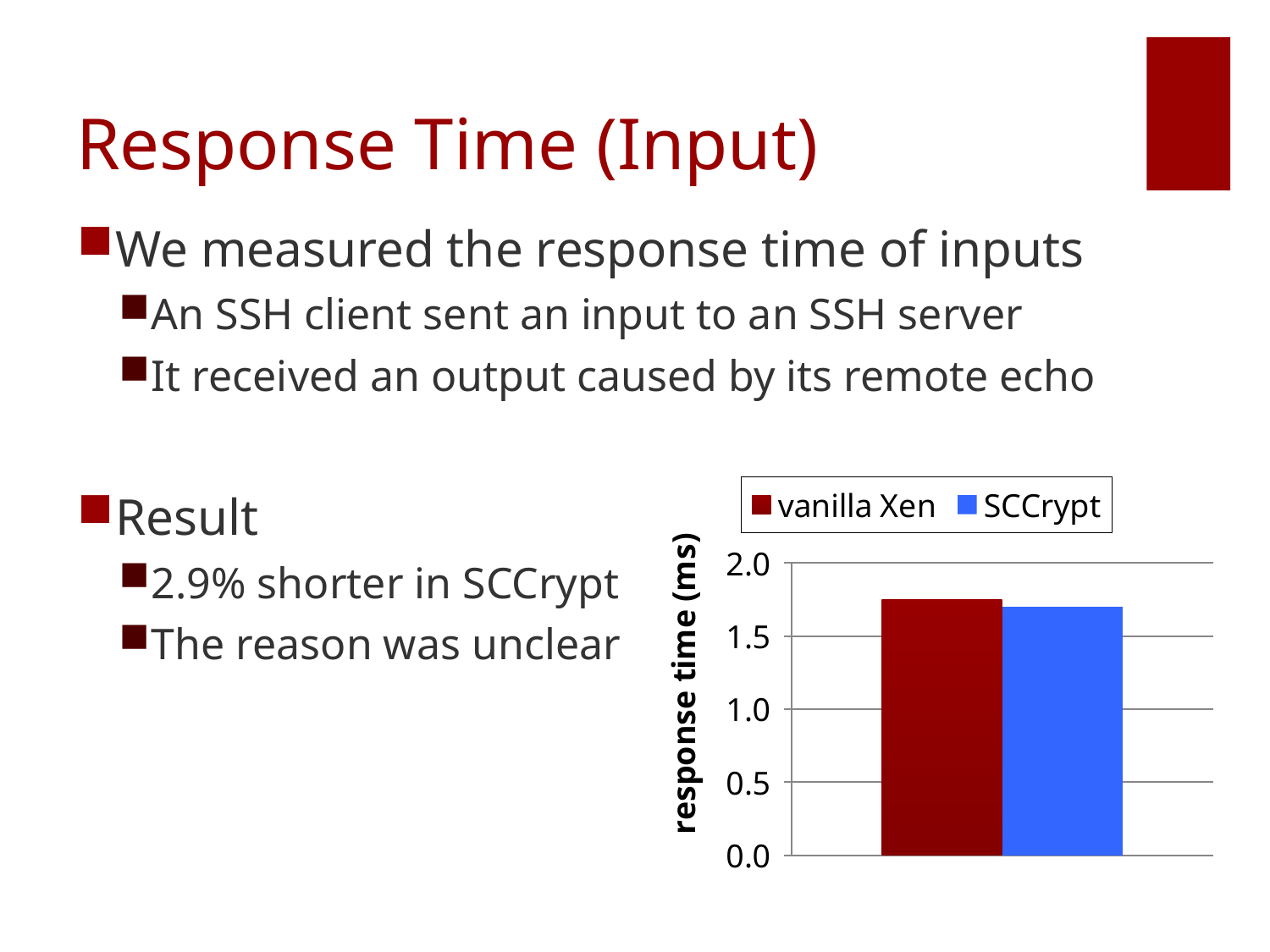
Is the response time for SCCrypt greater or less than 1.0 ms? greater What is the label of the chart's vertical axis? response time (ms) What is the highest value shown on the chart's vertical axis? 2.0 What kind of chart is shown on the slide? bar chart Is the response time for SCCrypt greater or less than 1.5 ms? greater How many series does the chart legend list? 2 Which two series are listed in the chart legend? vanilla Xen and SCCrypt Is the response time for vanilla Xen greater or less than 2.0 ms? less How many bars are plotted in the chart? 2